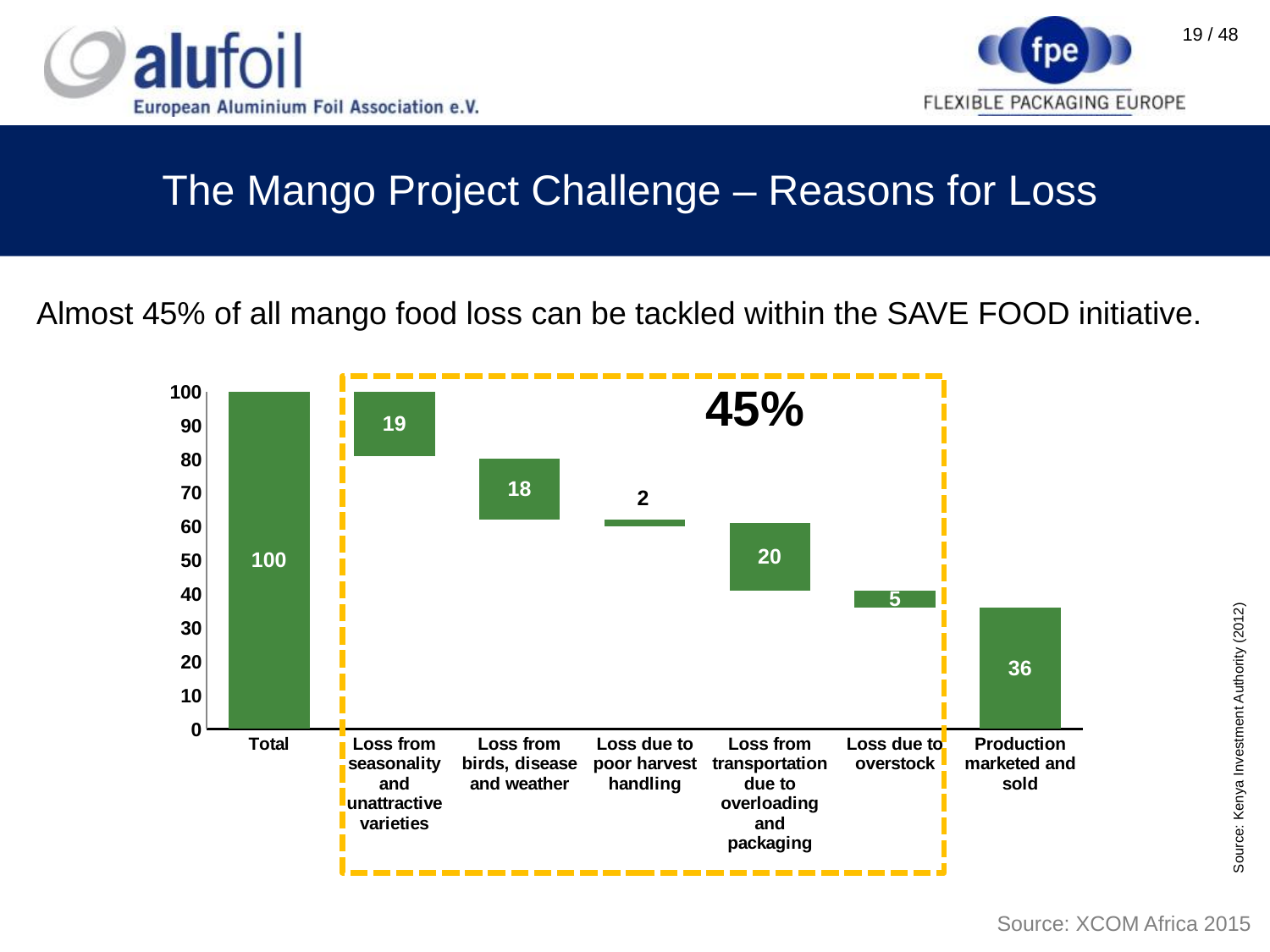
Which loss category has the smallest value? Loss due to poor harvest handling What is the value of the Total bar? 100 How many categories are shown on the x axis? 7 What is the difference between Loss from seasonality and unattractive varieties and Loss due to overstock? 14 What value is shown for Loss due to overstock? 5 What percentage is printed inside the dashed box on the chart? 45% What value is shown for Production marketed and sold? 36 Excluding the Total bar, which category has the largest value? Production marketed and sold What value is shown for Loss from transportation due to overloading and packaging? 20 What value is shown for Loss from birds, disease and weather? 18 Which is larger: Loss from transportation due to overloading and packaging or Loss from birds, disease and weather? Loss from transportation due to overloading and packaging What kind of chart is shown on the slide? Bar chart (waterfall)